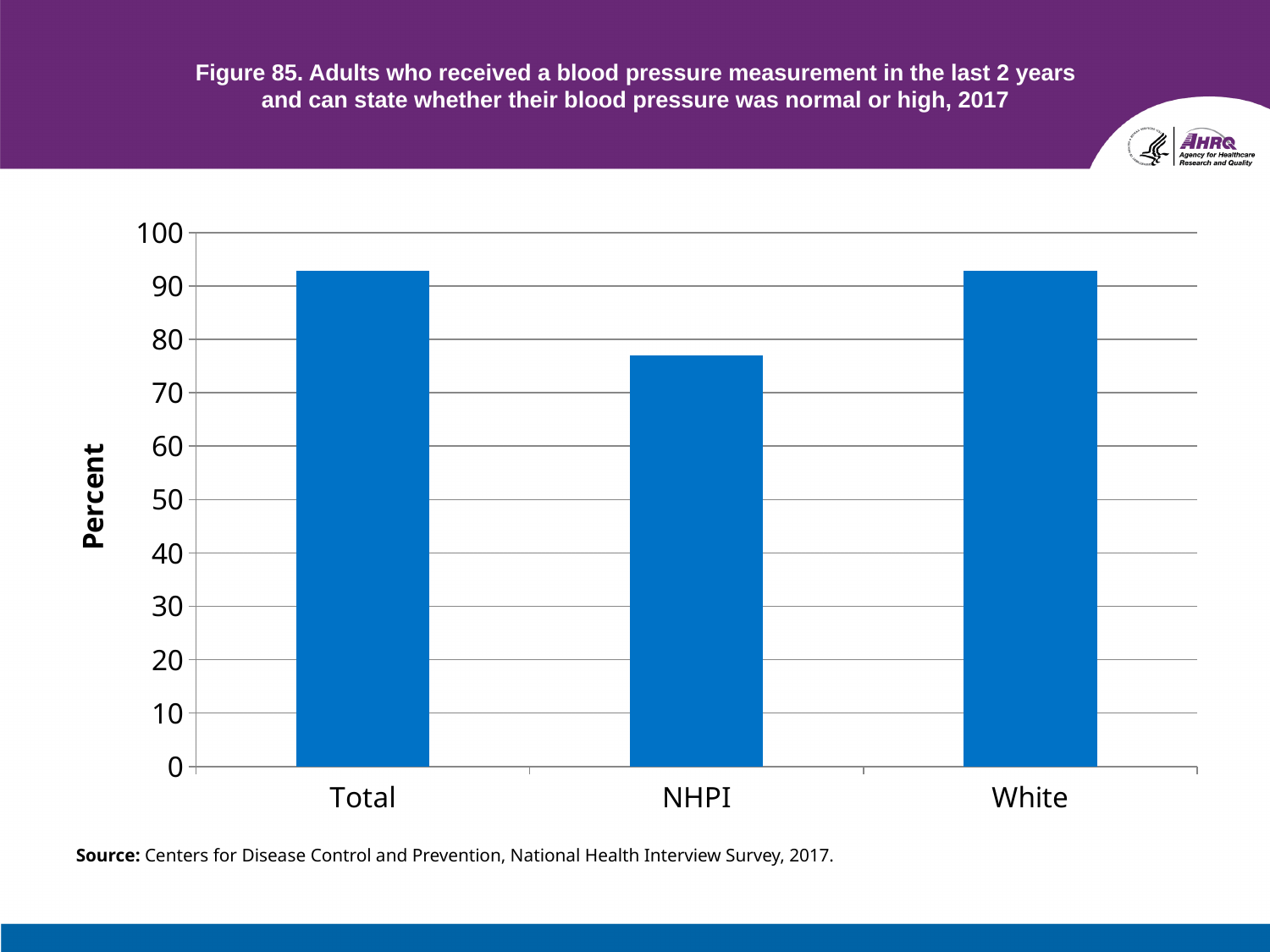
Which is larger, the value for Total or the value for NHPI? Total What kind of chart is shown on the slide? bar chart Which is larger, the value for White or the value for NHPI? White Is the value for NHPI greater or less than 70? greater Is the value for Total greater or less than 90? greater How many categories are shown on the x axis of the chart? 3 Which category has the lowest value in the chart? NHPI What is the label on the y axis of the chart? Percent Is the value for NHPI greater or less than 80? less What is the maximum value shown on the y axis of the chart? 100